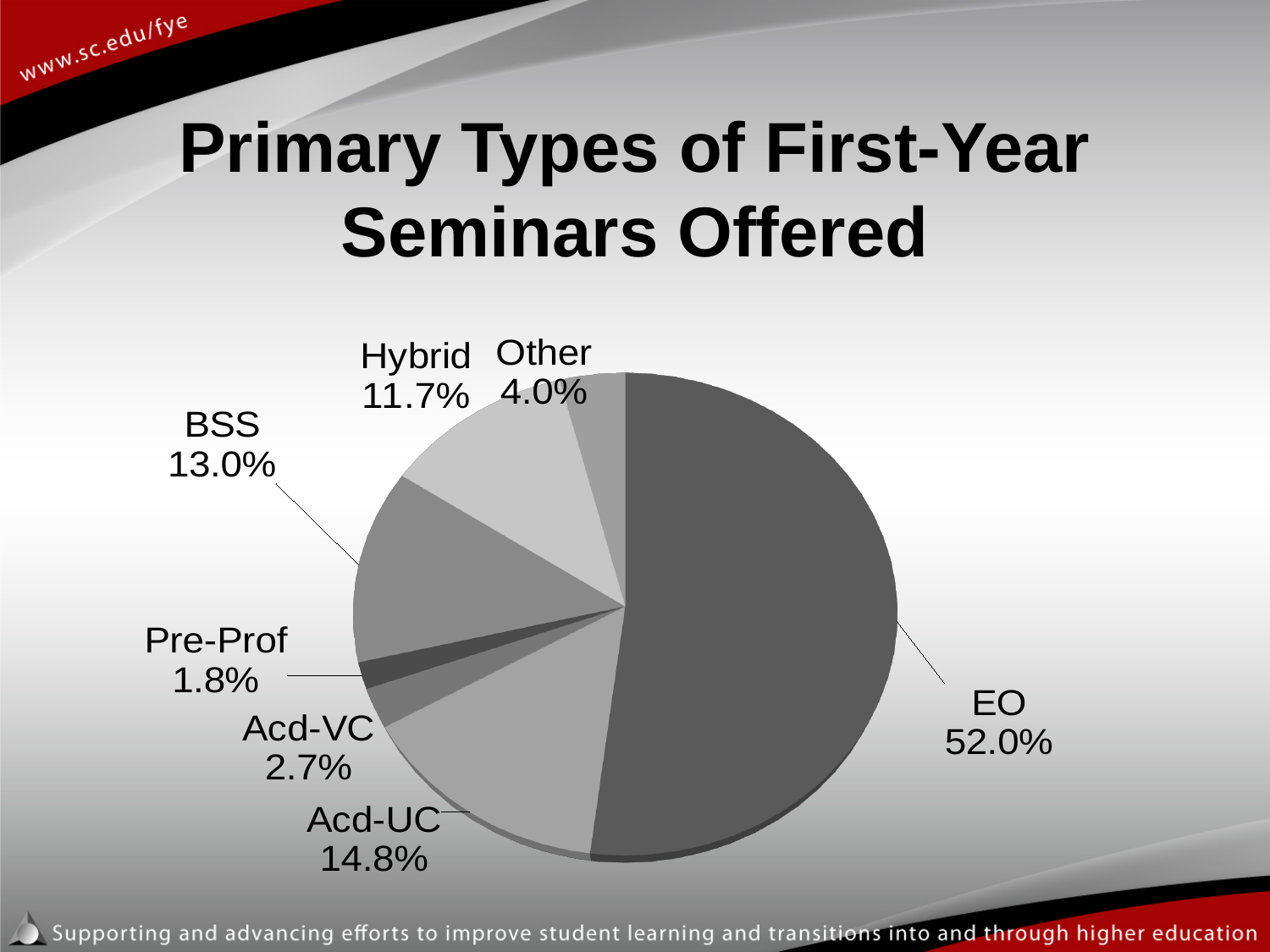
What percentage of first-year seminars are EO? 52.0% What is the difference between the BSS and Hybrid percentages? 1.3% What kind of chart is shown on the slide? pie chart What is the title of the chart? Primary Types of First-Year Seminars Offered What is the value shown for Hybrid? 11.7% What is the value shown for Acd-UC? 14.8% What is the combined share of Acd-VC and Other? 6.7% Which is larger, Acd-UC or BSS? Acd-UC Which category has the smallest slice of the pie? Pre-Prof What is the value shown for Pre-Prof? 1.8% How many categories are shown in the pie chart? 7 Which category has the largest slice of the pie? EO